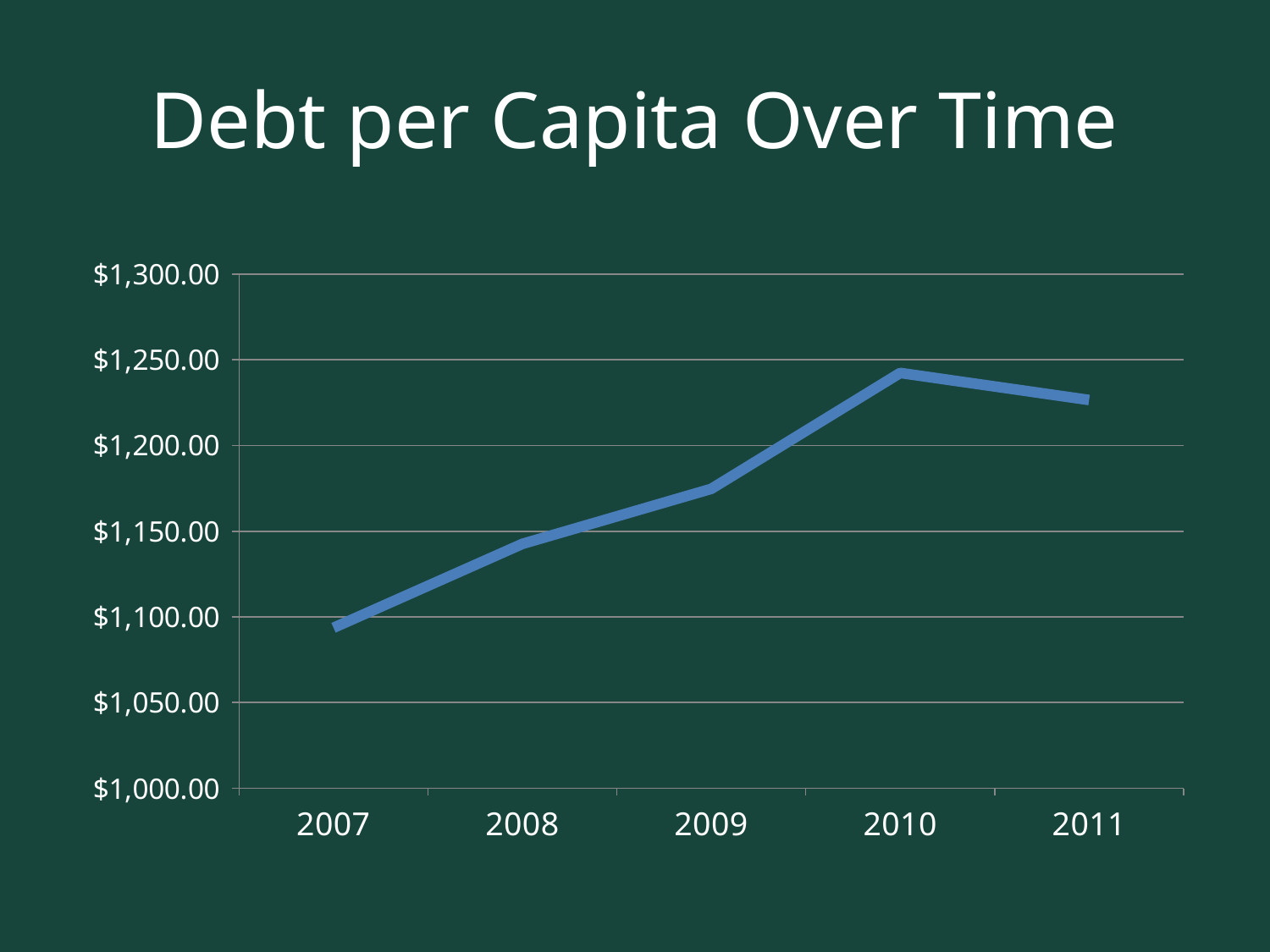
Does debt per capita rise or fall from 2010 to 2011? fall Which year has the lowest debt per capita? 2007 How many years are plotted on the x axis? 5 Does debt per capita rise or fall from 2007 to 2010? rise Is the value for 2007 greater or less than $1,050.00? greater Which year has the larger debt per capita, 2010 or 2011? 2010 Is the value for 2011 greater or less than $1,200.00? greater Is the value for 2009 greater or less than $1,150.00? greater What is the title of the chart? Debt per Capita Over Time Which year has the highest debt per capita? 2010 Which year has the larger debt per capita, 2007 or 2009? 2009 What kind of chart is shown on the slide? line chart